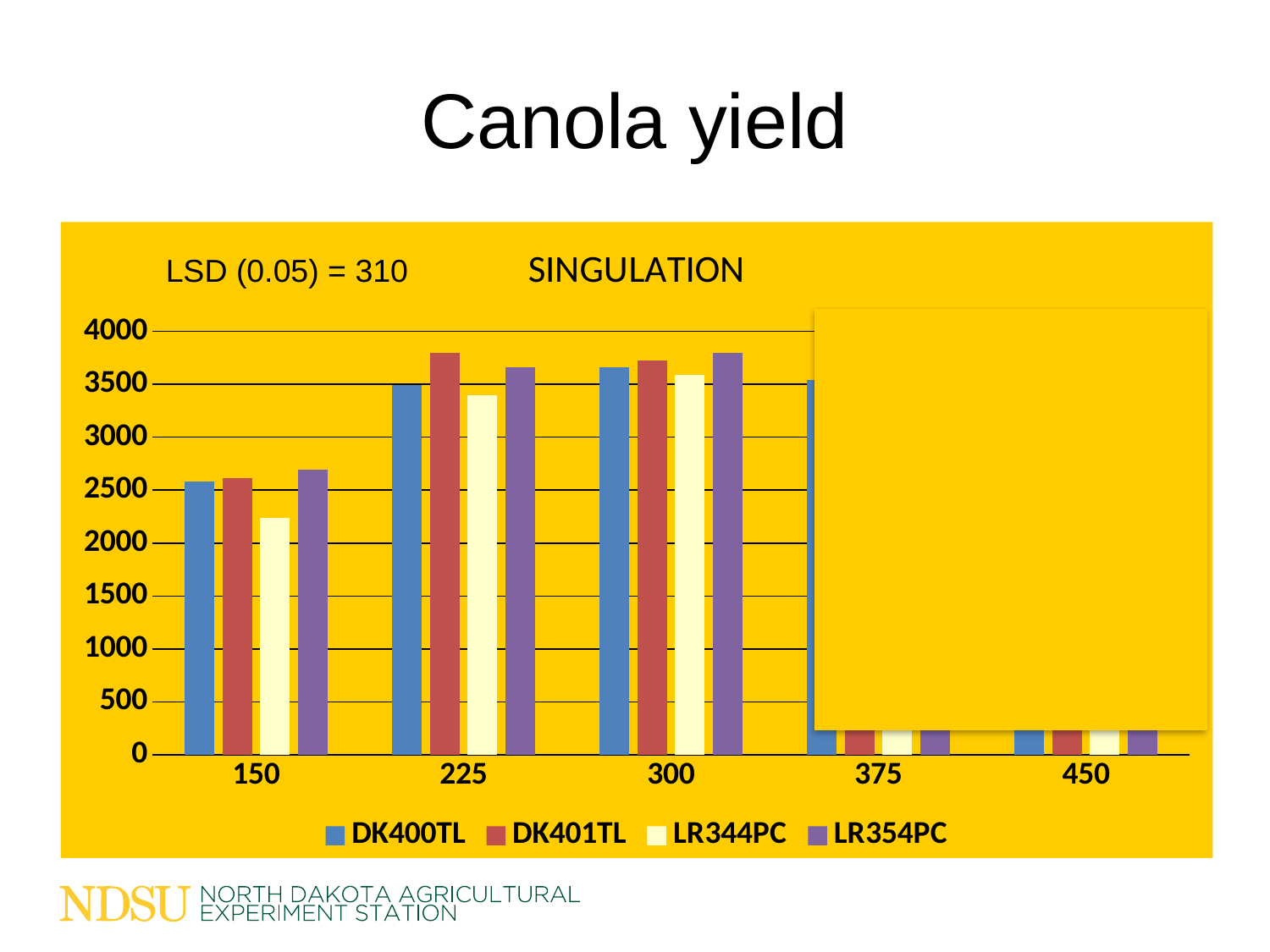
What LSD (0.05) value is printed on the chart? 310 What is the title of the chart? SINGULATION At 225, which is larger: DK401TL or LR344PC? DK401TL Which series has the lowest value at 150? LR344PC At 150, which is larger: LR354PC or LR344PC? LR354PC How many categories are shown on the x axis? 5 Is the value for LR354PC at 150 greater or less than 2500? greater Is the value for DK401TL at 225 greater or less than 3500? greater Is the value for LR344PC at 150 greater or less than 2500? less What kind of chart is shown on the slide? bar chart How many series does the legend list? 4